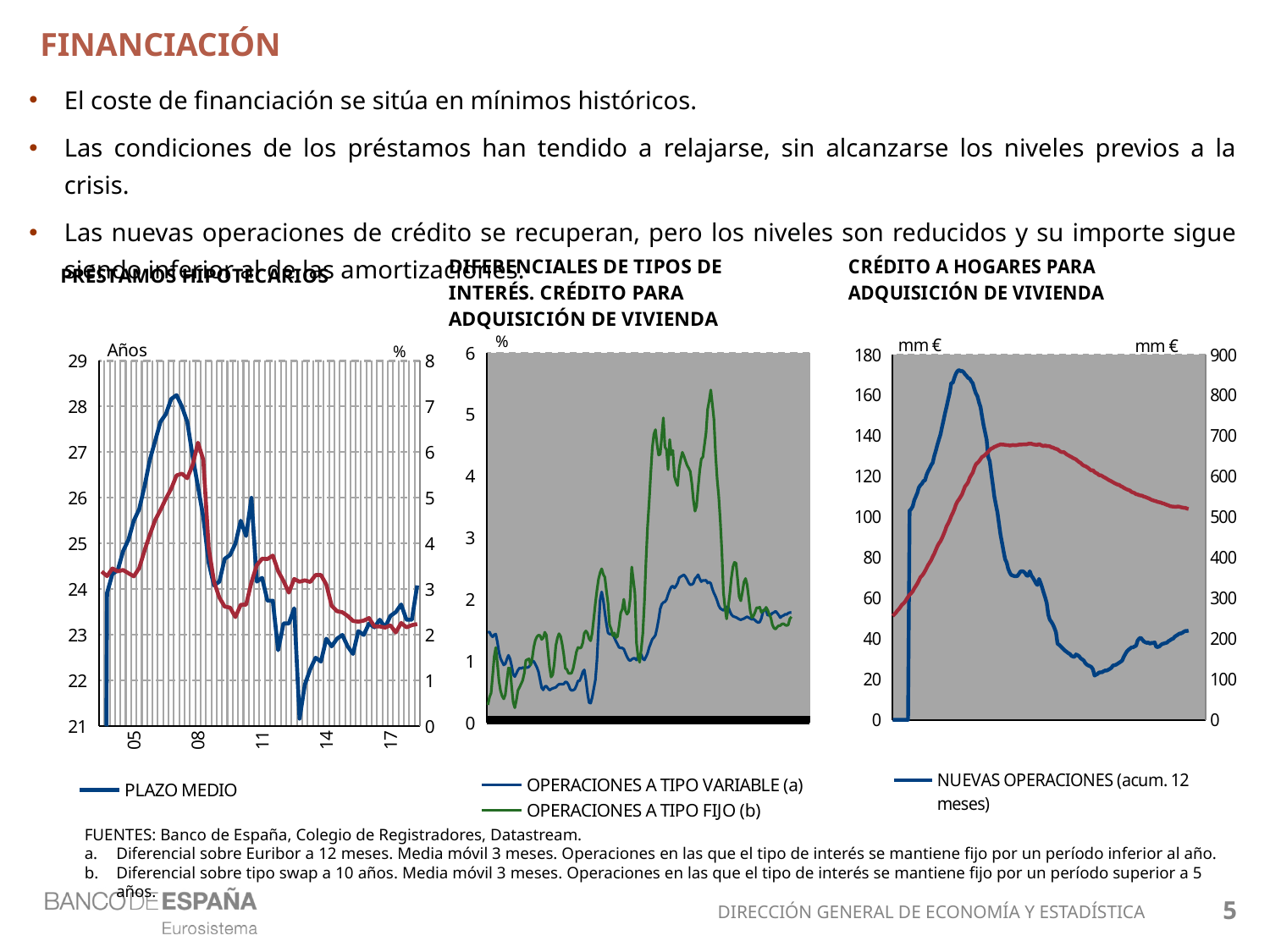
In the 'DIFERENCIALES DE TIPOS DE INTERÉS' chart, is the highest value reached by OPERACIONES A TIPO VARIABLE (a) greater or less than 3? less In the 'CRÉDITO A HOGARES PARA ADQUISICIÓN DE VIVIENDA' chart, is the peak of NUEVAS OPERACIONES (acum. 12 meses) greater or less than 160 on the left axis? greater How many series does the legend of the 'DIFERENCIALES DE TIPOS DE INTERÉS' chart list? 2 In the 'PRÉSTAMOS HIPOTECARIOS' chart, is the peak of PLAZO MEDIO greater or less than 27 years? greater In the 'DIFERENCIALES DE TIPOS DE INTERÉS' chart, does the OPERACIONES A TIPO FIJO (b) line end higher or lower than it starts? higher What kind of chart is the 'DIFERENCIALES DE TIPOS DE INTERÉS. CRÉDITO PARA ADQUISICIÓN DE VIVIENDA' chart? Line chart What is the unit shown on the left axis of the 'PRÉSTAMOS HIPOTECARIOS' chart? Años What kind of chart is the 'CRÉDITO A HOGARES PARA ADQUISICIÓN DE VIVIENDA' chart? Line chart How many series does the legend of the 'CRÉDITO A HOGARES PARA ADQUISICIÓN DE VIVIENDA' chart list? 1 What series does the legend of the 'PRÉSTAMOS HIPOTECARIOS' chart list? PLAZO MEDIO